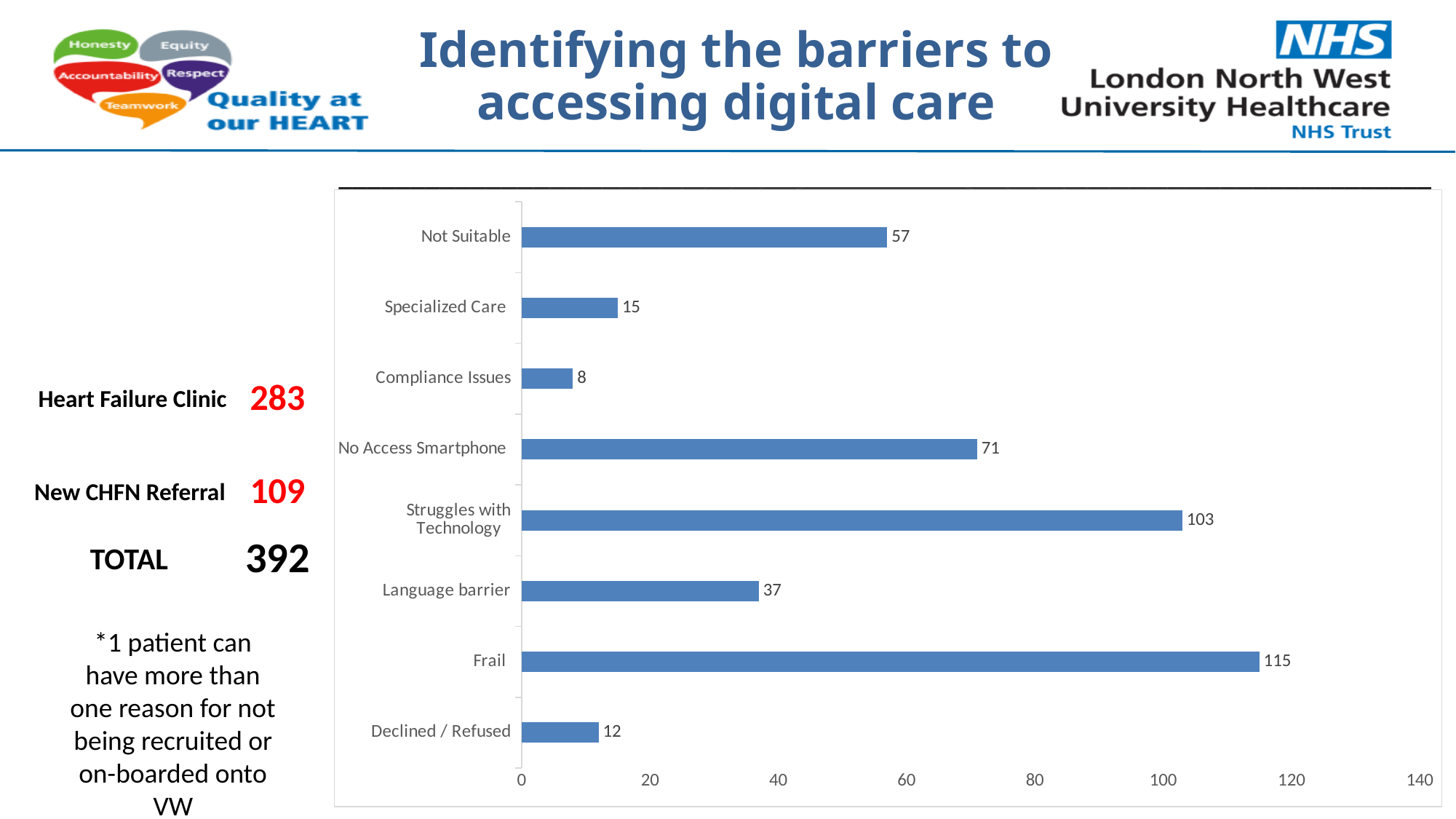
What is the value for No Access Smartphone? 71 Which is larger, the value for Not Suitable or the value for Language barrier? Not Suitable What is the maximum value shown on the x axis? 140 What kind of chart is shown on the slide? Bar chart What is the difference between the values for Specialized Care and Declined / Refused? 3 What is the value for Compliance Issues? 8 How many categories are shown in the chart? 8 Which category has the lowest value? Compliance Issues What is the difference between the values for Frail and Struggles with Technology? 12 Which category has the highest value? Frail What is the value for Frail? 115 Is the value for Struggles with Technology greater or less than 100? greater